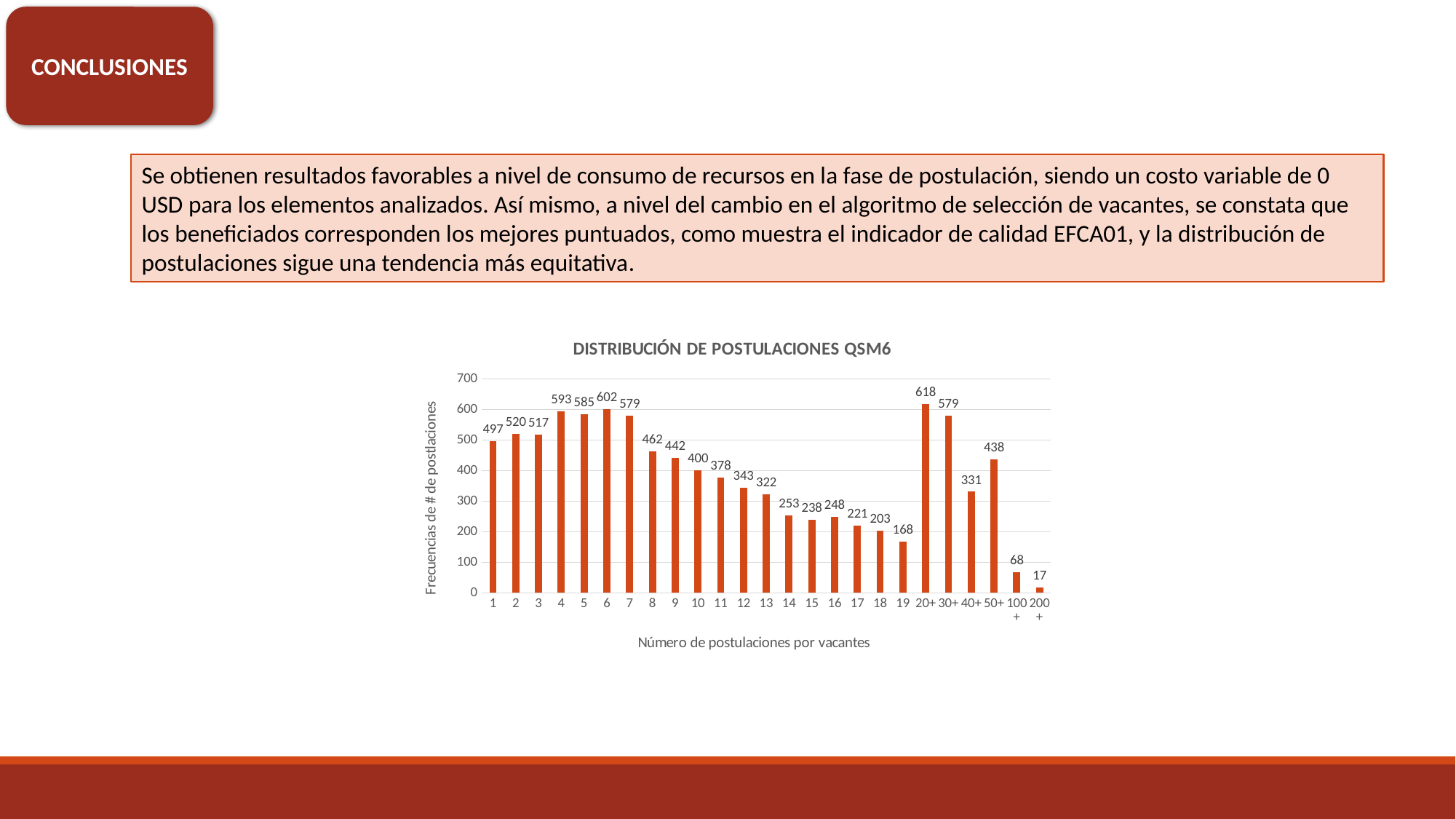
How many categories are shown on the x axis? 25 Do the values rise or fall from category 7 to category 19? Fall What is the difference between the values for category 1 and category 2? 23 What is the value for category 200+? 17 Which is larger, the value for category 40+ or the value for category 50+? 50+ What kind of chart is shown on the slide? Bar chart Which category has the lowest value? 200+ What is the label of the y axis? Frecuencias de # de postlaciones What is the value for category 20+? 618 What is the value for category 6? 602 What is the title of the chart? DISTRIBUCIÓN DE POSTULACIONES QSM6 Which category has the highest value? 20+